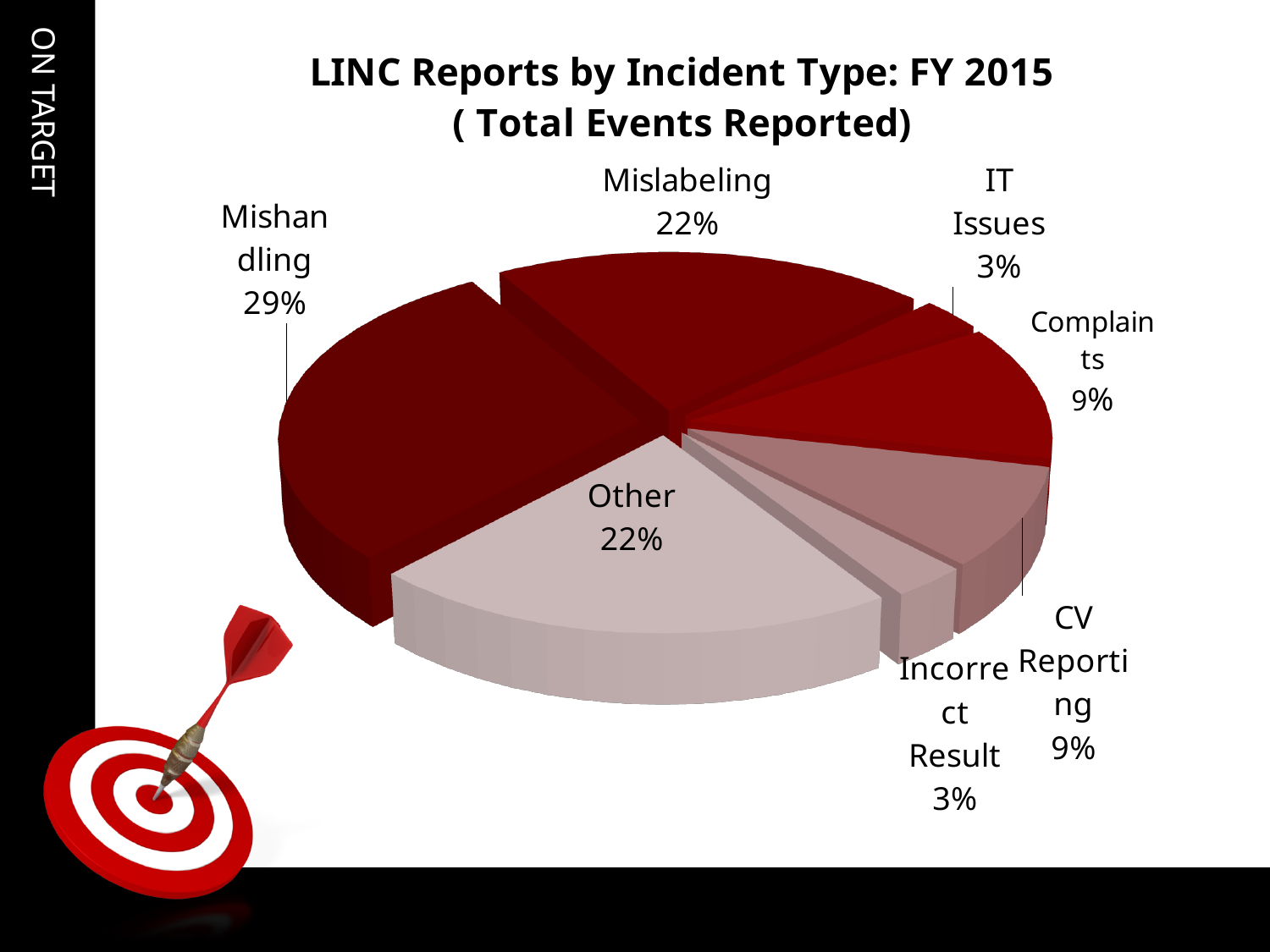
What is the difference in percentage points between CV Reporting and Incorrect Result? 6% What percentage is shown for IT Issues? 3% Which incident type has the largest share of LINC reports? Mishandling What share of LINC reports is attributed to Mishandling? 29% What is the difference in percentage points between Mishandling and Mislabeling? 7% What percentage of the pie is labeled Mislabeling? 22% How many incident type categories are shown in the pie chart? 7 What is the title of the chart? LINC Reports by Incident Type: FY 2015 ( Total Events Reported) Which is larger, the share for Complaints or the share for IT Issues? Complaints What kind of chart is shown on the slide? Pie chart